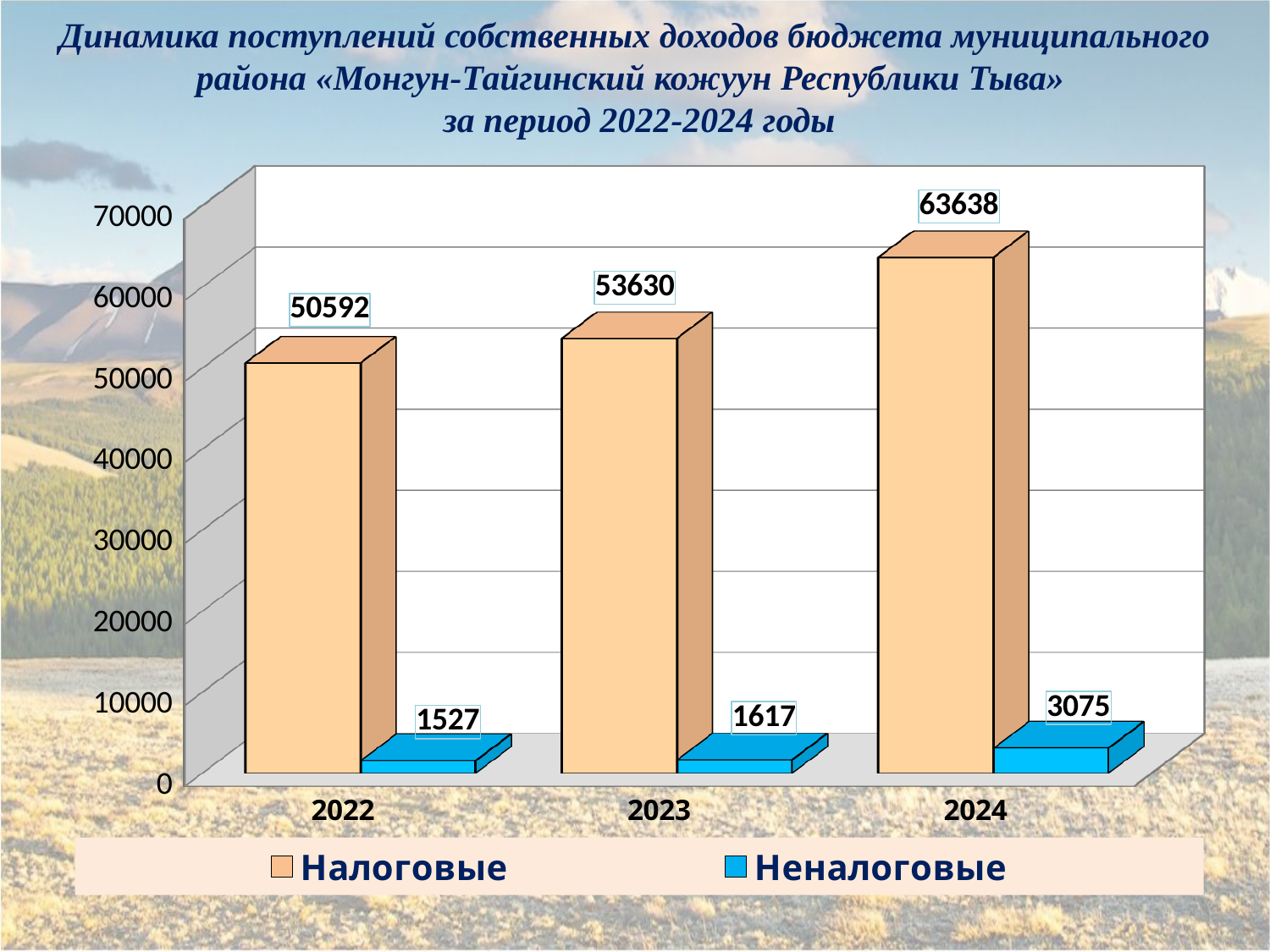
What is the difference between Налоговые in 2024 and Налоговые in 2023? 10008 What is the difference between Неналоговые in 2024 and Неналоговые in 2022? 1548 In which year is Неналоговые lowest? 2022 What is the value of Налоговые for 2023? 53630 In which year is Налоговые highest? 2024 How many years are shown on the x axis? 3 Is the value of Налоговые for 2024 greater or less than 60000? greater What kind of chart is shown on the slide? bar chart What is the value of Неналоговые for 2024? 3075 Which is larger: Налоговые in 2022 or Налоговые in 2023? Налоговые in 2023 What is the value of Налоговые for 2022? 50592 How many series does the legend list? 2